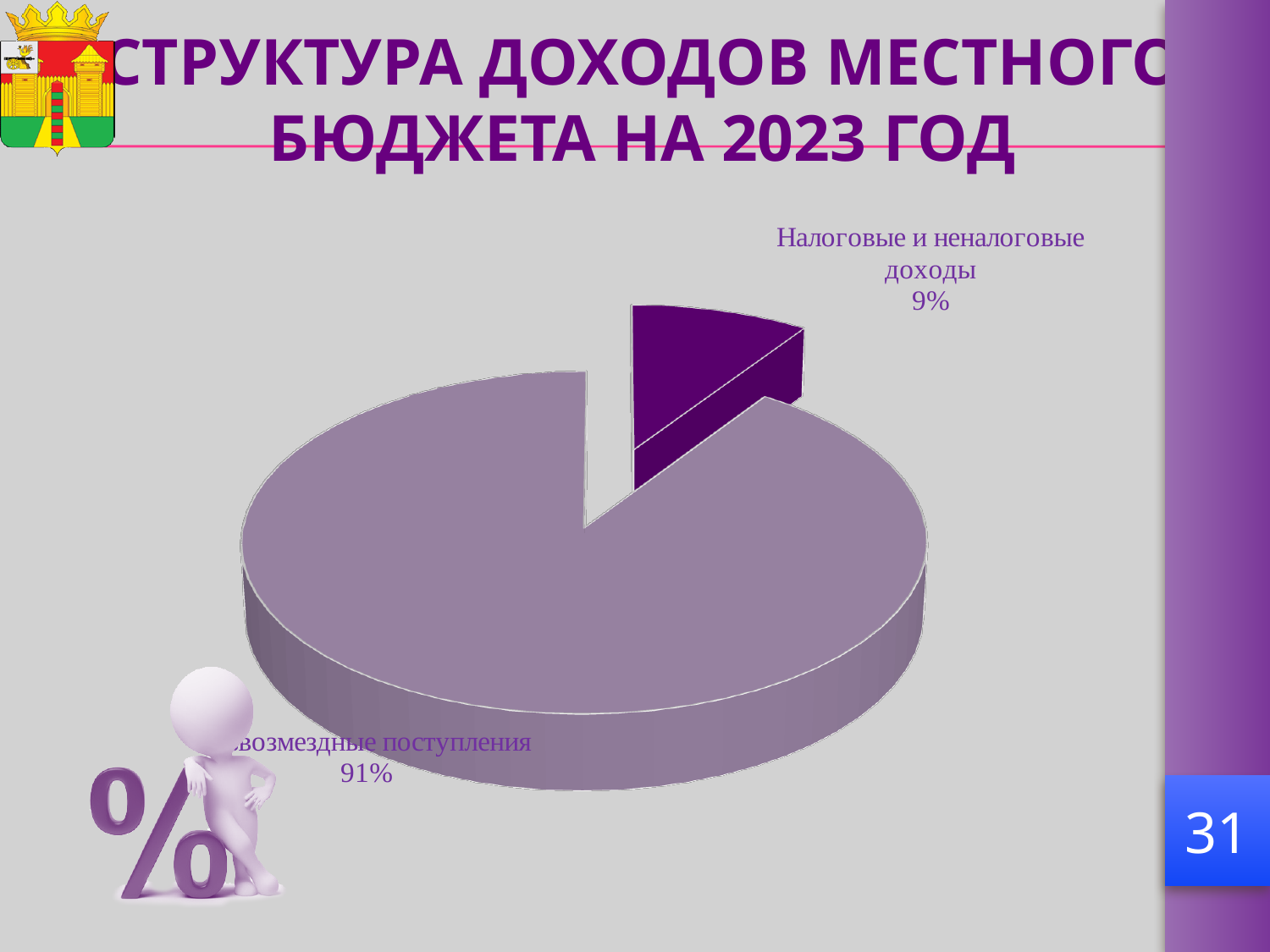
What is the difference in percentage points between the "Безвозмездные поступления" slice and the "Налоговые и неналоговые доходы" slice? 82 What kind of chart is shown on the slide? Pie chart Which slice is drawn in dark purple and pulled out from the pie? Налоговые и неналоговые доходы What share of the pie is labelled "Налоговые и неналоговые доходы"? 9% Which is larger: the share for "Налоговые и неналоговые доходы" or the share for "Безвозмездные поступления"? Безвозмездные поступления Which category has the largest share of the pie? Безвозмездные поступления Is the share for "Налоговые и неналоговые доходы" greater or less than 10%? less How many slices does the pie chart have? 2 What share of the pie is labelled "Безвозмездные поступления"? 91% Which category has the smallest share of the pie? Налоговые и неналоговые доходы What is the title of the slide containing the pie chart? СТРУКТУРА ДОХОДОВ МЕСТНОГО БЮДЖЕТА НА 2023 ГОД What do the two slice percentages add up to? 100%